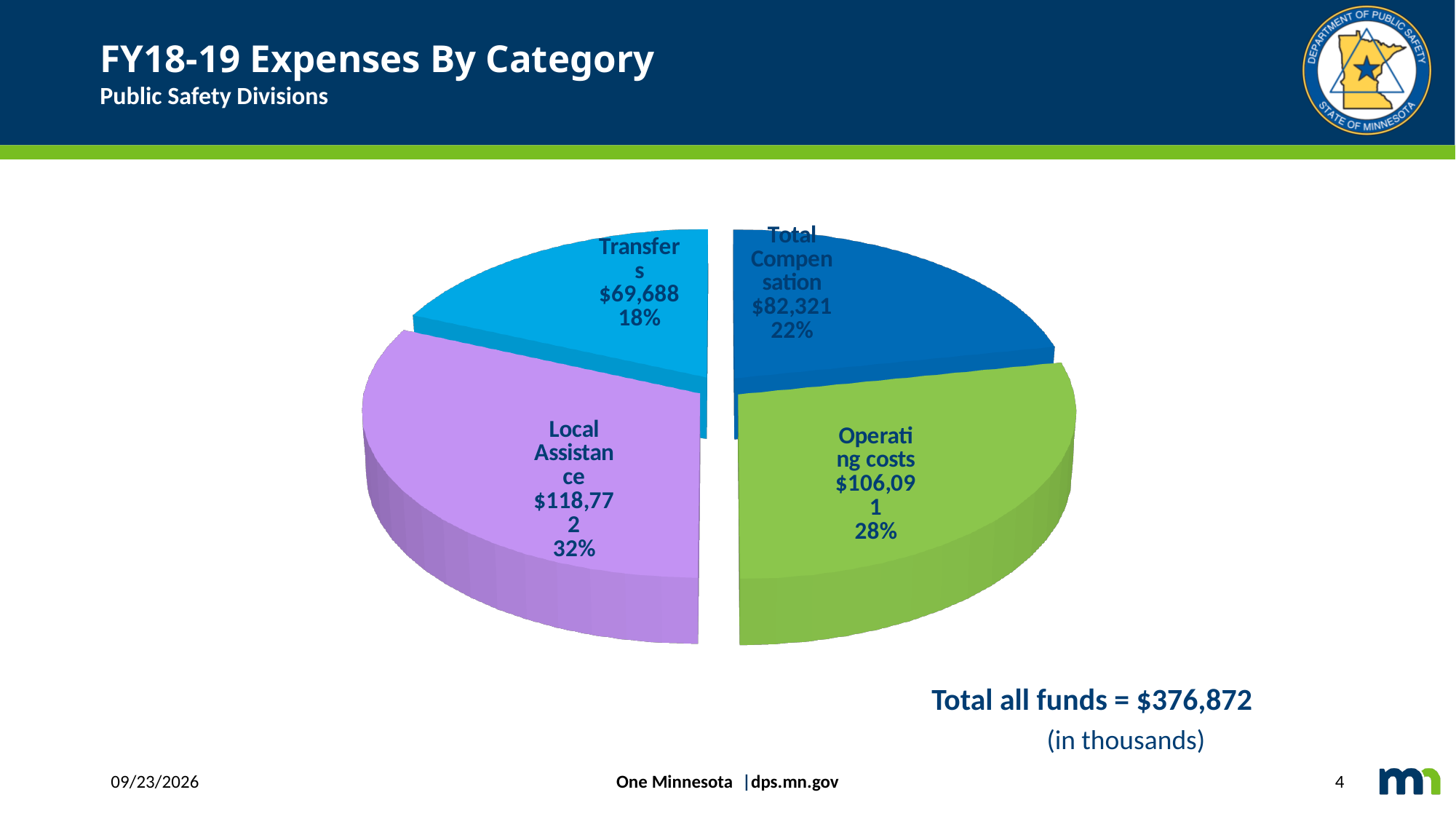
What percentage share does Operating costs have? 28% What percentage share does Transfers have? 18% What is the value for Total Compensation? $82,321 Which is larger, Operating costs or Total Compensation? Operating costs What kind of chart is shown on the slide? Pie chart How many categories are shown in the pie chart? 4 Which category has the smallest share of expenses? Transfers What is the value for Local Assistance? $118,772 Which category has the largest share of expenses? Local Assistance What is the difference between Local Assistance and Total Compensation? $36,451 What is the value for Operating costs? $106,091 What is the value for Transfers? $69,688